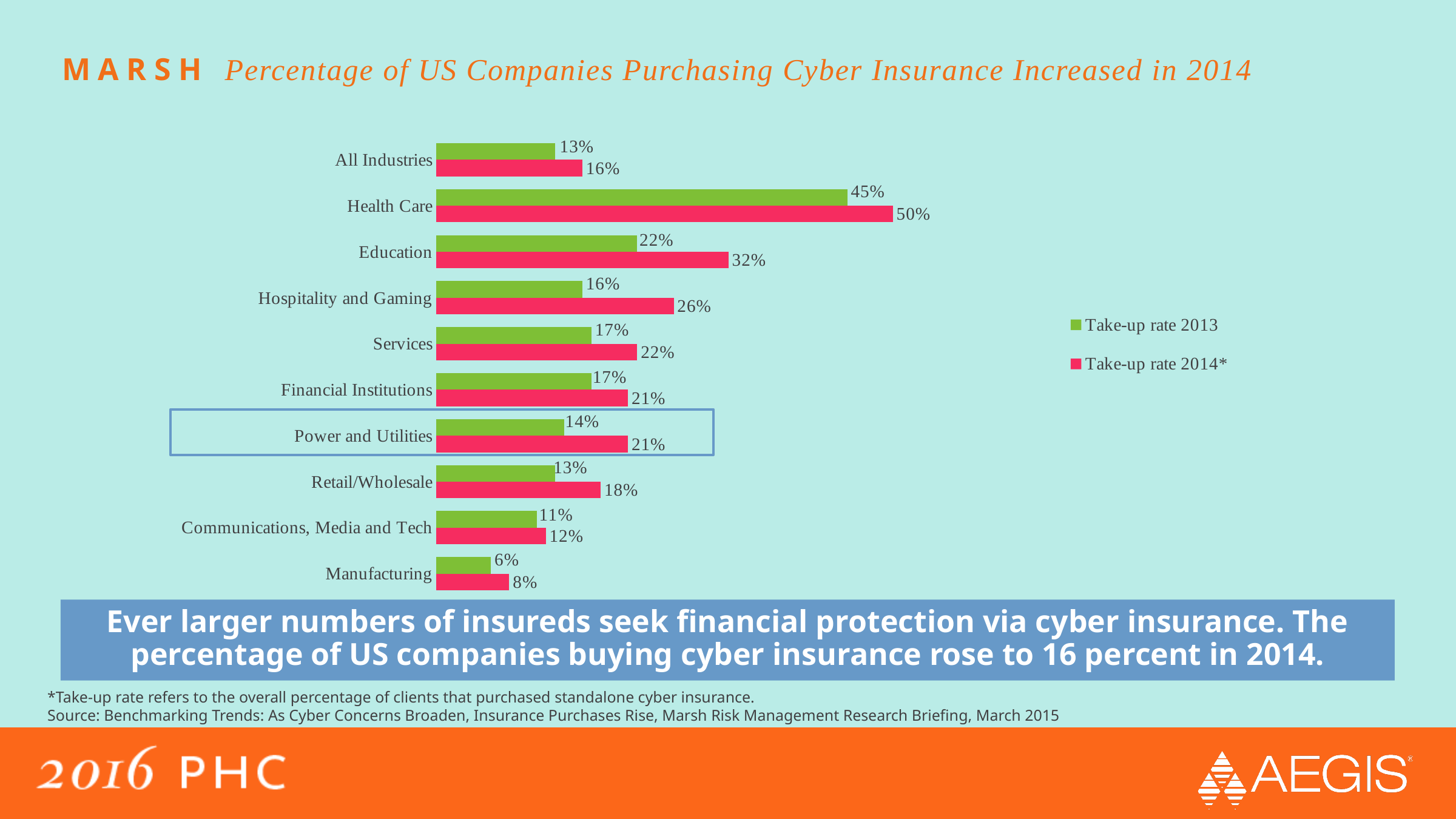
How many series does the legend list? 2 Which category has the lowest Take-up rate 2013? Manufacturing Which category has the highest Take-up rate 2014*? Health Care What is the difference between the Take-up rate 2014* and the Take-up rate 2013 for Hospitality and Gaming? 10% What kind of chart is shown on the slide? Bar chart What is the Take-up rate 2014* for Health Care? 50% How many industry categories are shown on the chart? 10 Which colour represents the Take-up rate 2014* series? Red (pink) What is the Take-up rate 2014* for Education? 32% What is the Take-up rate 2013 for Power and Utilities? 14% What is the Take-up rate 2013 for All Industries? 13% Which is larger: the Take-up rate 2014* for Retail/Wholesale or for Communications, Media and Tech? Retail/Wholesale